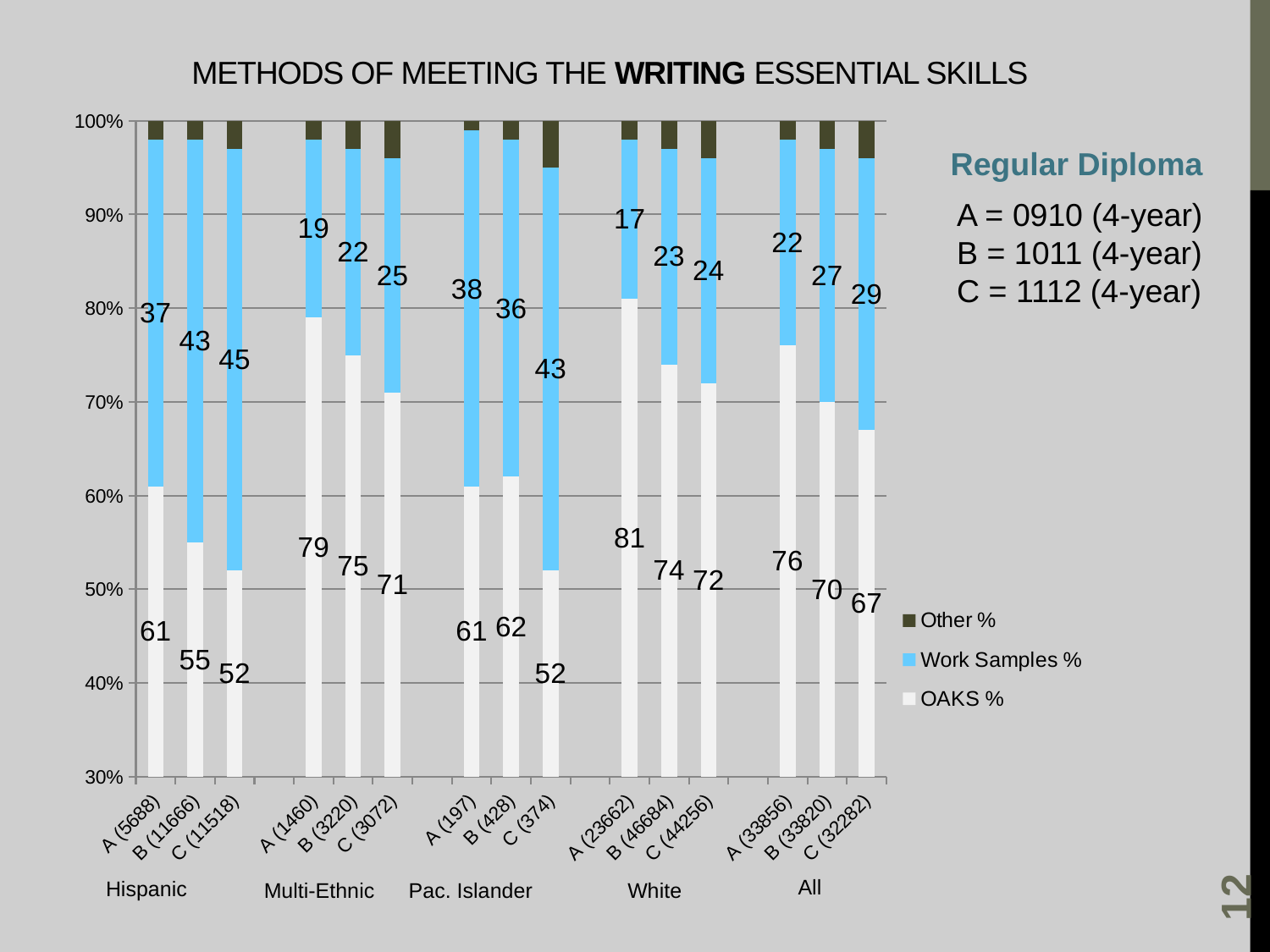
What is the title of the chart? METHODS OF MEETING THE WRITING ESSENTIAL SKILLS How many series does the legend list? 3 How many bars are plotted in the chart? 15 What is the OAKS % value for the All B (33820) bar? 70 What is the Work Samples % value for the Hispanic C (11518) bar? 45 Which bar has the lowest Work Samples % value? White A (23662) What is the difference between the OAKS % values for Multi-Ethnic A (1460) and Multi-Ethnic C (3072)? 8 Which has a larger Work Samples % value: Pac. Islander A (197) or All C (32282)? Pac. Islander A (197) What type of chart is shown on the slide? Stacked bar chart What is the OAKS % value for the White A (23662) bar? 81 Which bar has the highest OAKS % value? White A (23662) Within the Hispanic group, does the OAKS % value rise or fall from A to C? Fall